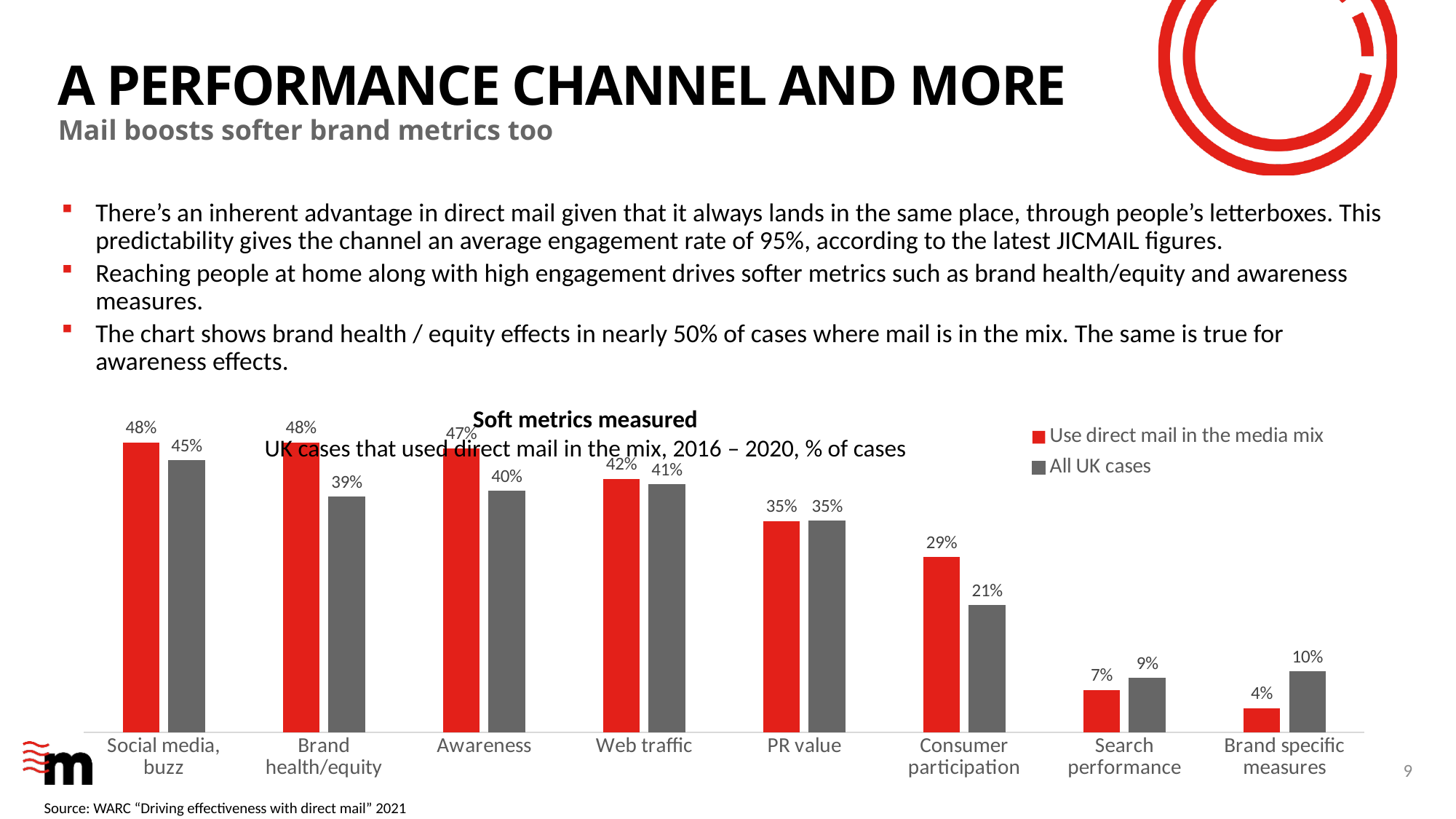
What is the value for Consumer participation in the 'All UK cases' series? 21% What type of chart is shown on the slide? Bar chart How many categories are shown on the x axis of the chart? 8 What is the value for Brand health/equity in the 'Use direct mail in the media mix' series? 48% Which category has the highest value in the 'All UK cases' series? Social media, buzz Which category has the lowest value in the 'All UK cases' series? Search performance What is the value for Brand specific measures in the 'Use direct mail in the media mix' series? 4% How many series does the chart legend list? 2 Which category has the lowest value in the 'Use direct mail in the media mix' series? Brand specific measures What is the difference between the 'Use direct mail in the media mix' and 'All UK cases' values for Brand health/equity? 9% What colour are the bars for the 'Use direct mail in the media mix' series? Red For Search performance, which series has the larger value: 'Use direct mail in the media mix' or 'All UK cases'? All UK cases